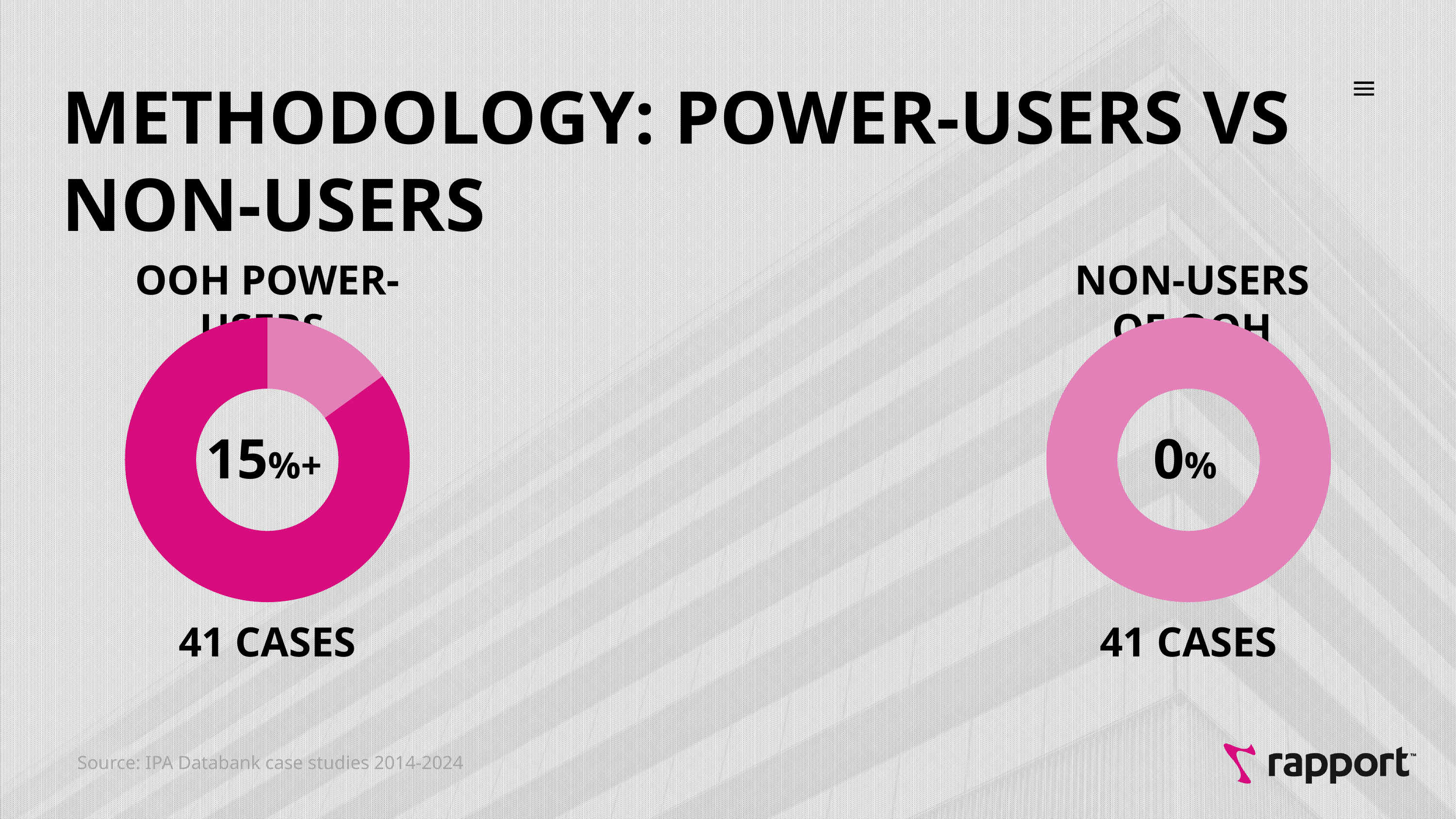
How many cases are shown beneath the OOH Power-Users donut chart? 41 CASES What value is printed in the centre of the right donut chart (Non-Users of OOH)? 0% In the left donut chart (OOH Power-Users), which segment is larger, the dark magenta one or the light pink one? Dark magenta How many donut charts are on the slide? 2 How many cases are shown beneath the Non-Users of OOH donut chart? 41 CASES Which chart has the larger centre value, the OOH Power-Users chart or the Non-Users of OOH chart? OOH Power-Users What kind of chart is used on this slide? Donut chart What source is cited for the data in the charts? IPA Databank case studies 2014-2024 How many segments does the right donut chart (Non-Users of OOH) have? 1 What is the title of the slide containing the two donut charts? METHODOLOGY: POWER-USERS VS NON-USERS How many segments does the left donut chart (OOH Power-Users) have? 2 What value is printed in the centre of the left donut chart (OOH Power-Users)? 15%+